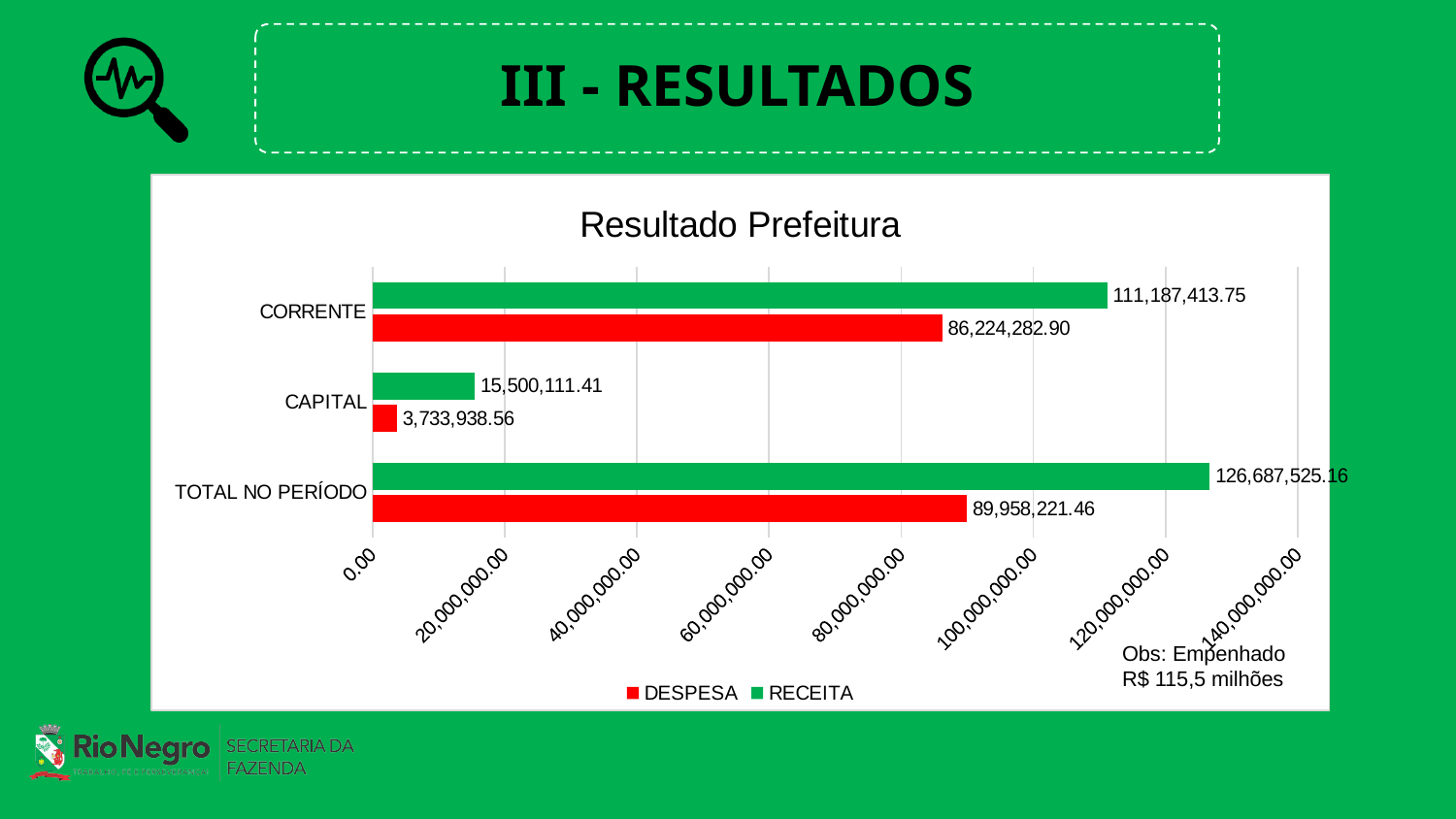
What is the RECEITA value for CORRENTE? 111,187,413.75 Which category has the highest RECEITA value? TOTAL NO PERÍODO What is the difference between RECEITA and DESPESA for CORRENTE? 24,963,130.85 What is the DESPESA value for CAPITAL? 3,733,938.56 How many series does the legend list? 2 What is the RECEITA value for TOTAL NO PERÍODO? 126,687,525.16 What is the DESPESA value for TOTAL NO PERÍODO? 89,958,221.46 What is the difference between RECEITA and DESPESA for TOTAL NO PERÍODO? 36,729,303.70 Which is larger for CAPITAL, RECEITA or DESPESA? RECEITA What type of chart is shown on the slide? Bar chart Which category has the lowest DESPESA value? CAPITAL How many categories are shown on the chart? 3